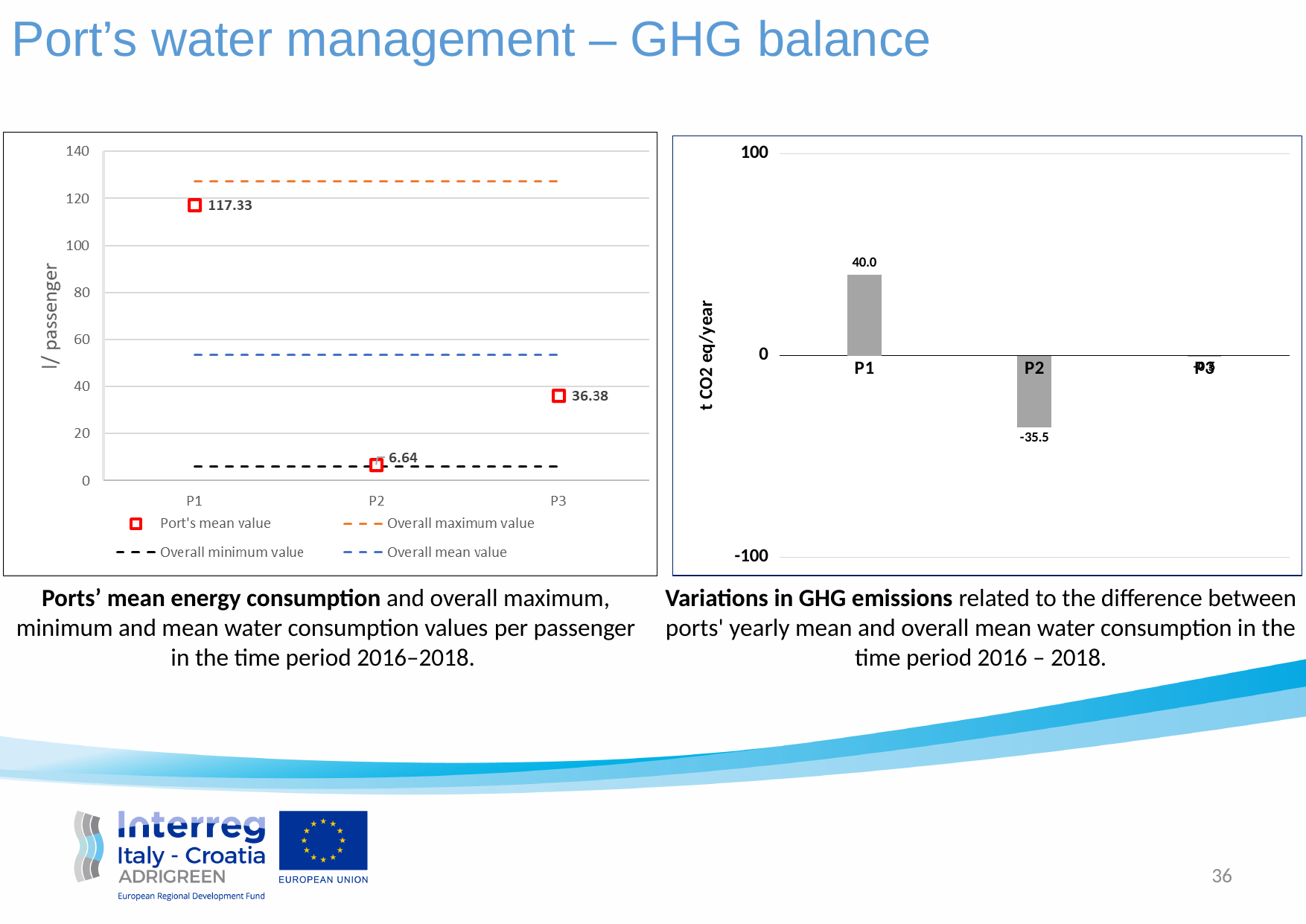
In the left chart, which port has the lowest mean value? P2 In the left chart, what is the port's mean value for P3? 36.38 In the right chart, what is the value for P1? 40.0 What kind of chart is the right chart? bar chart In the left chart, how many entries does the legend list? 4 In the left chart, what is the difference between the port's mean values for P1 and P3? 80.95 In the left chart, which port has the highest mean value? P1 In the right chart, what is the value for P2? -35.5 In the left chart, what is the port's mean value for P2? 6.64 In the left chart, what is the port's mean value for P1? 117.33 In the left chart, is the overall mean value line greater or less than 40? greater In the right chart, which port has the highest value? P1